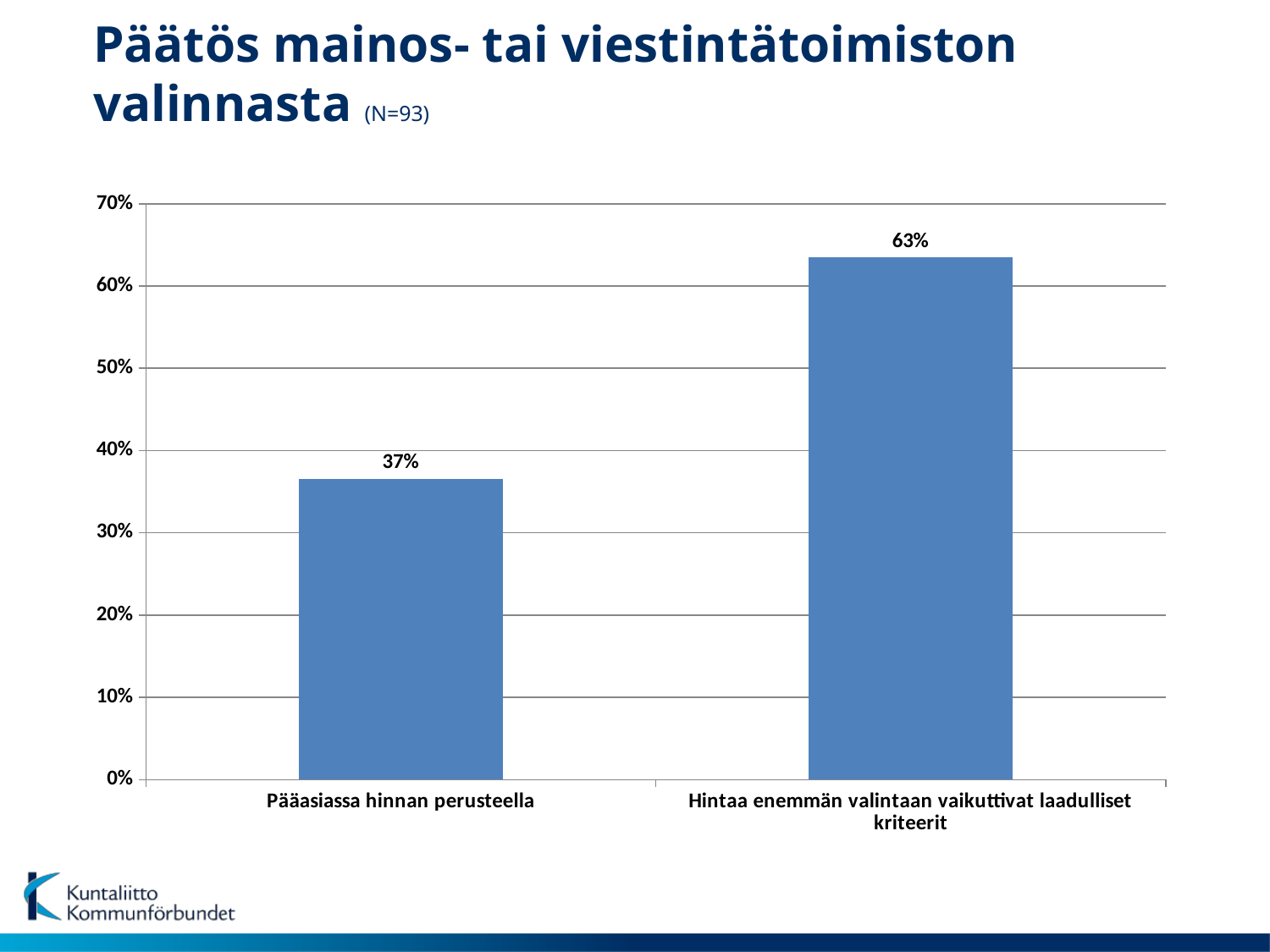
What is the sample size (N) given in the slide title? N=93 What is the value for "Hintaa enemmän valintaan vaikuttivat laadulliset kriteerit"? 63% What is the total of the two values shown in the chart? 100% What kind of chart is shown on the slide? bar chart How many categories are shown in the chart? 2 What is the difference between the values for "Hintaa enemmän valintaan vaikuttivat laadulliset kriteerit" and "Pääasiassa hinnan perusteella"? 26% Which category has the lowest value? Pääasiassa hinnan perusteella Which is larger: the value for "Pääasiassa hinnan perusteella" or for "Hintaa enemmän valintaan vaikuttivat laadulliset kriteerit"? Hintaa enemmän valintaan vaikuttivat laadulliset kriteerit What is the value for "Pääasiassa hinnan perusteella"? 37% Is the value for "Hintaa enemmän valintaan vaikuttivat laadulliset kriteerit" greater or less than 60%? greater Which category has the highest value? Hintaa enemmän valintaan vaikuttivat laadulliset kriteerit Is the value for "Pääasiassa hinnan perusteella" greater or less than 40%? less